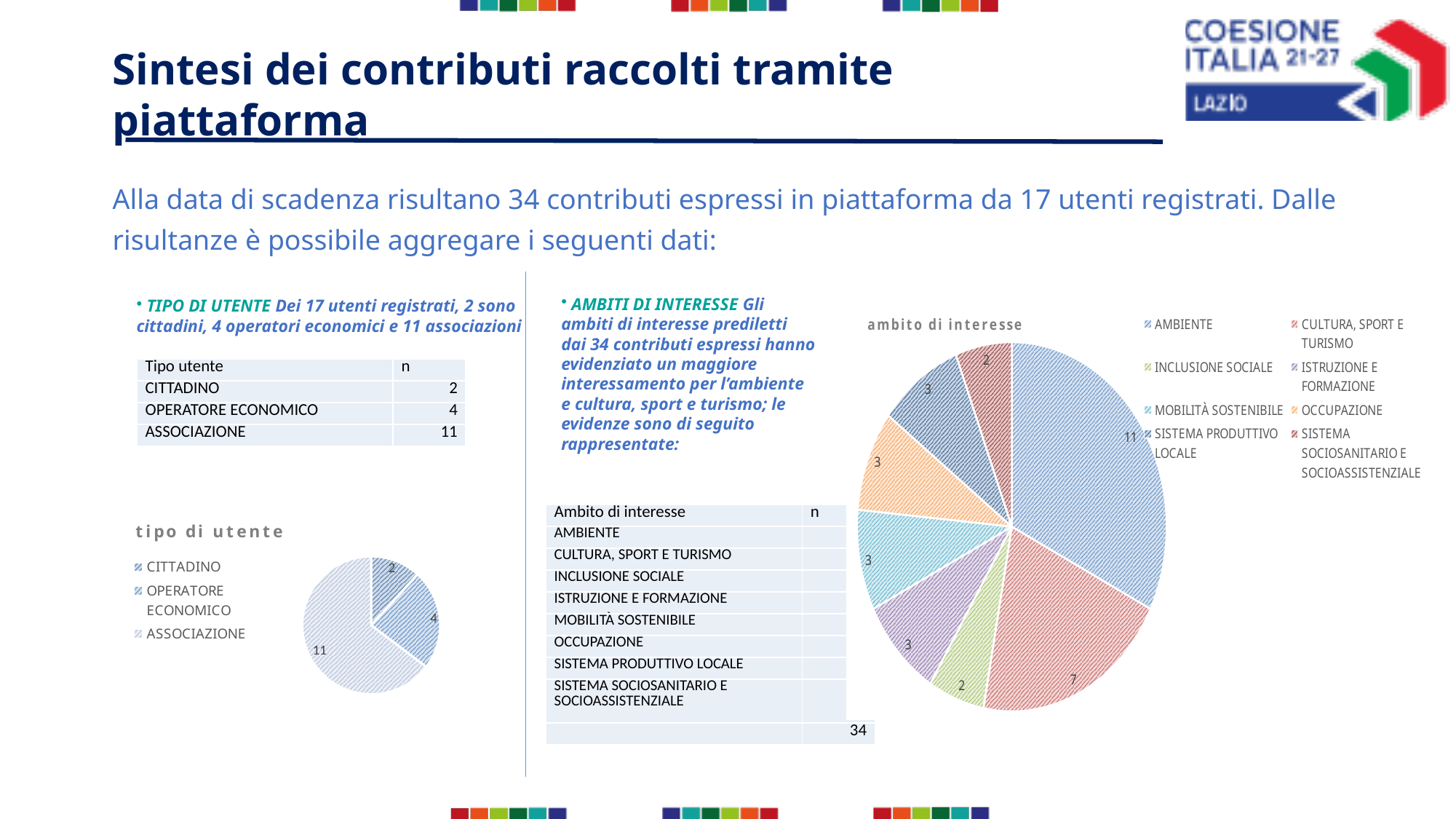
How many categories does the legend of the 'ambito di interesse' chart list? 8 In the 'ambito di interesse' chart, which is larger: AMBIENTE or CULTURA, SPORT E TURISMO? AMBIENTE In the 'tipo di utente' chart, what is the value for ASSOCIAZIONE? 11 What kind of chart is the 'tipo di utente' chart? pie chart In the 'ambito di interesse' chart, what is the value for AMBIENTE? 11 In the 'ambito di interesse' chart, what is the value for CULTURA, SPORT E TURISMO? 7 In the 'ambito di interesse' chart, which category has the largest slice? AMBIENTE What kind of chart is the 'ambito di interesse' chart? pie chart In the 'tipo di utente' chart, what is the difference between ASSOCIAZIONE and CITTADINO? 9 In the 'tipo di utente' chart, what is the value for OPERATORE ECONOMICO? 4 How many categories does the 'tipo di utente' chart show? 3 In the 'tipo di utente' chart, which category has the smallest slice? CITTADINO